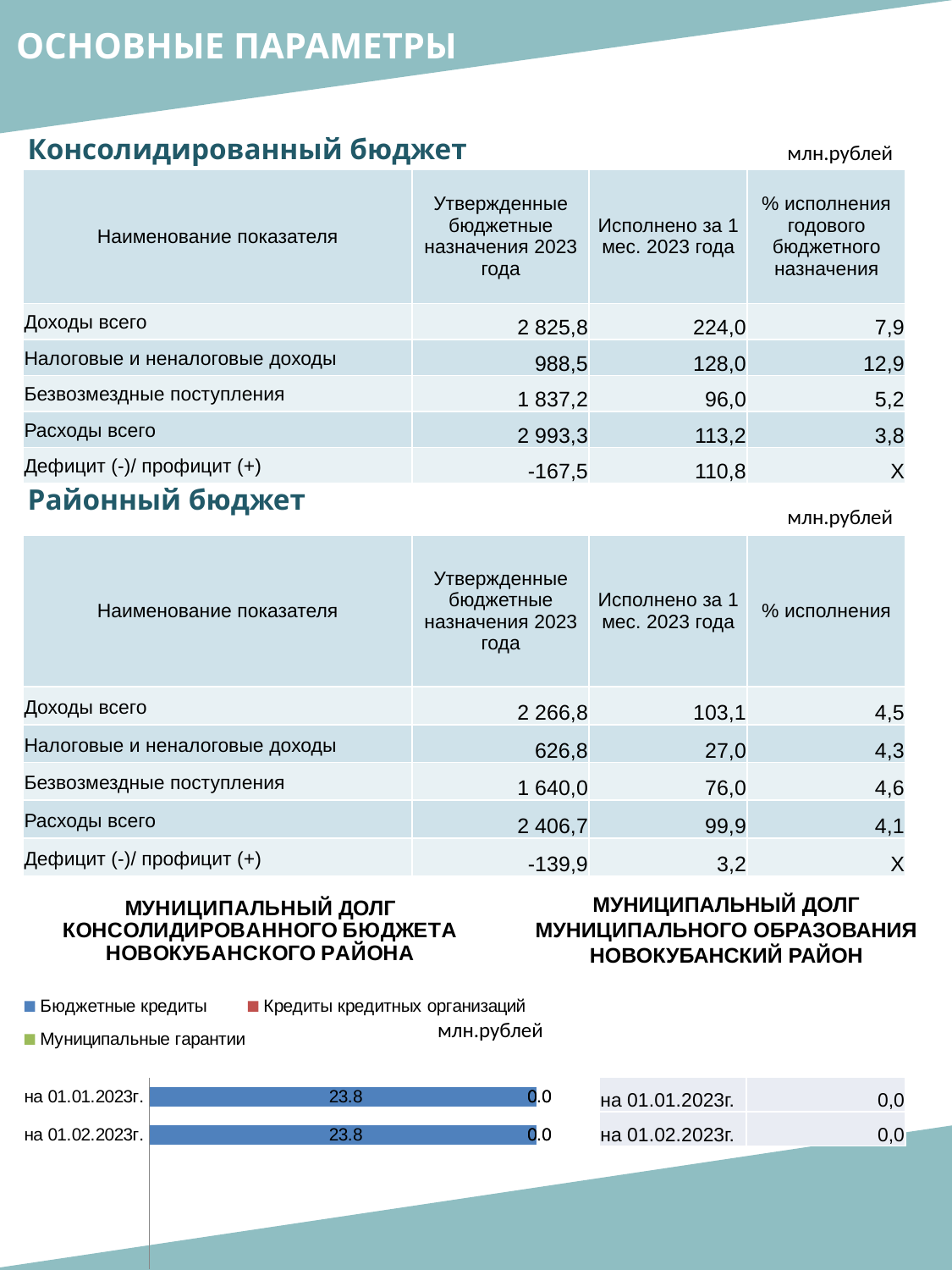
What unit is stated for the municipal debt chart? млн.рублей In the municipal debt chart, does the value of 'Бюджетные кредиты' rise, fall or stay the same from 'на 01.01.2023г.' to 'на 01.02.2023г.'? stays the same How many series does the legend of the municipal debt chart list? 3 Which legend entry in the municipal debt chart is shown in blue? Бюджетные кредиты What kind of chart is shown under the title 'МУНИЦИПАЛЬНЫЙ ДОЛГ КОНСОЛИДИРОВАННОГО БЮДЖЕТА НОВОКУБАНСКОГО РАЙОНА'? bar chart How many categories (dates) are shown on the municipal debt chart? 2 In the municipal debt chart, what is the value of 'Бюджетные кредиты' for 'на 01.02.2023г.'? 23.8 In the municipal debt chart, what is the difference between the 'Бюджетные кредиты' values for 'на 01.01.2023г.' and 'на 01.02.2023г.'? 0.0 In the municipal debt chart, which is larger for 'на 01.02.2023г.': the 'Бюджетные кредиты' bar (23.8) or the bar labelled 0.0? Бюджетные кредиты In the municipal debt chart, what is the value of 'Бюджетные кредиты' for 'на 01.01.2023г.'? 23.8